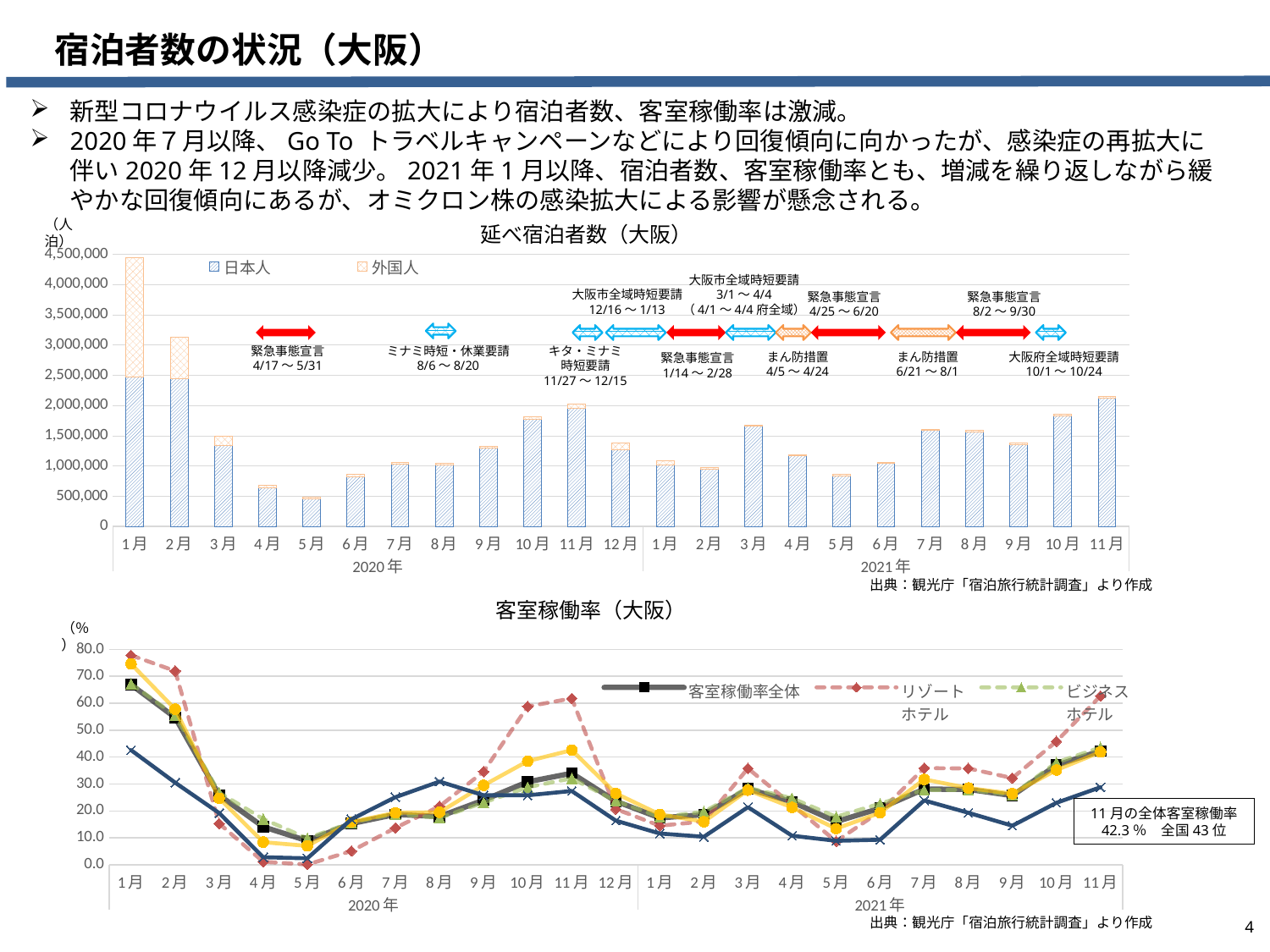
客室稼働率（大阪）のグラフで、2021年11月の全体客室稼働率は何%ですか？ 42.3% 延べ宿泊者数（大阪）のグラフには何か月分の棒がありますか？ 23 客室稼働率（大阪）のグラフで、2020年1月から2020年5月にかけて客室稼働率全体は上昇していますか、下降していますか？ 下降 延べ宿泊者数（大阪）のグラフで、2020年4月の値は1,000,000より大きいですか、小さいですか？ 小さい 延べ宿泊者数（大阪）のグラフの凡例にはいくつの系列がありますか？ 2 延べ宿泊者数（大阪）のグラフで、2020年1月の値は4,000,000より大きいですか、小さいですか？ 大きい 延べ宿泊者数（大阪）のグラフで、2020年11月と2020年12月ではどちらの延べ宿泊者数が多いですか？ 2020年11月 延べ宿泊者数（大阪）のグラフで、2021年11月の値は2,000,000より大きいですか、小さいですか？ 大きい 客室稼働率（大阪）のグラフはどの種類のグラフですか？ 折れ線グラフ 延べ宿泊者数（大阪）のグラフで、延べ宿泊者数が最も少ない月はどれですか？ 2020年5月 延べ宿泊者数（大阪）のグラフはどの種類のグラフですか？ 棒グラフ 延べ宿泊者数（大阪）のグラフで、延べ宿泊者数が最も多い月はどれですか？ 2020年1月